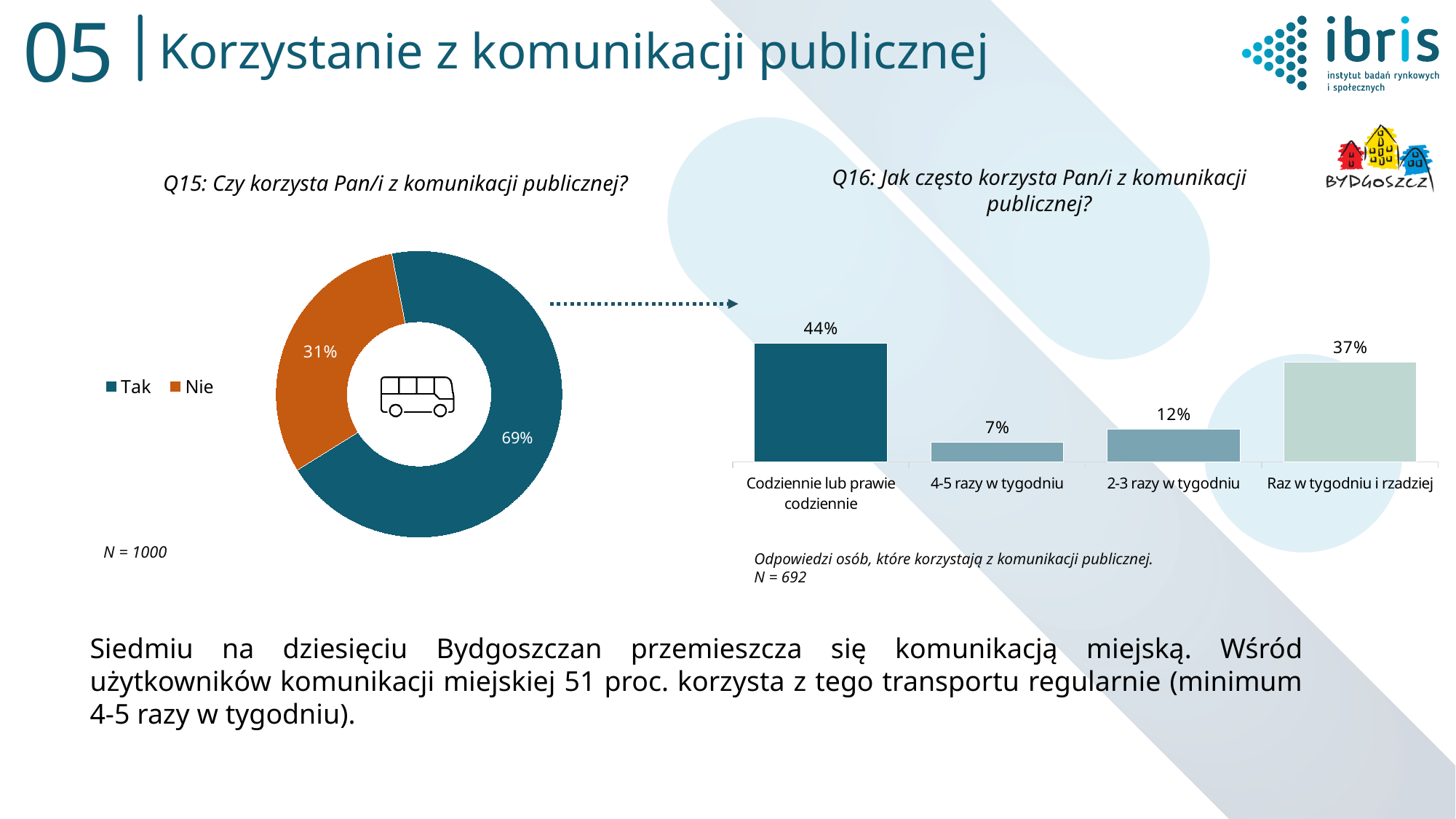
In the Q16 bar chart on the right, what is the difference in percentage points between "2-3 razy w tygodniu" and "4-5 razy w tygodniu"? 5 In the Q16 bar chart on the right, which category has the lowest value? 4-5 razy w tygodniu In the Q16 bar chart on the right, what is the value for "Codziennie lub prawie codziennie"? 44% In the Q15 donut chart on the left, what percentage answered "Tak"? 69% In the Q15 chart on the left, which answer has the larger share, "Tak" or "Nie"? Tak How many entries does the legend of the Q15 chart on the left list? 2 In the Q16 bar chart on the right, which category has the highest value? Codziennie lub prawie codziennie In the Q15 chart on the left, what is the difference in percentage points between "Tak" and "Nie"? 38 In the Q15 donut chart on the left, what percentage answered "Nie"? 31% In the Q16 bar chart on the right, what is the value for "Raz w tygodniu i rzadziej"? 37% How many categories are shown in the Q16 bar chart on the right? 4 What kind of chart is the Q15 chart on the left? Donut (pie) chart